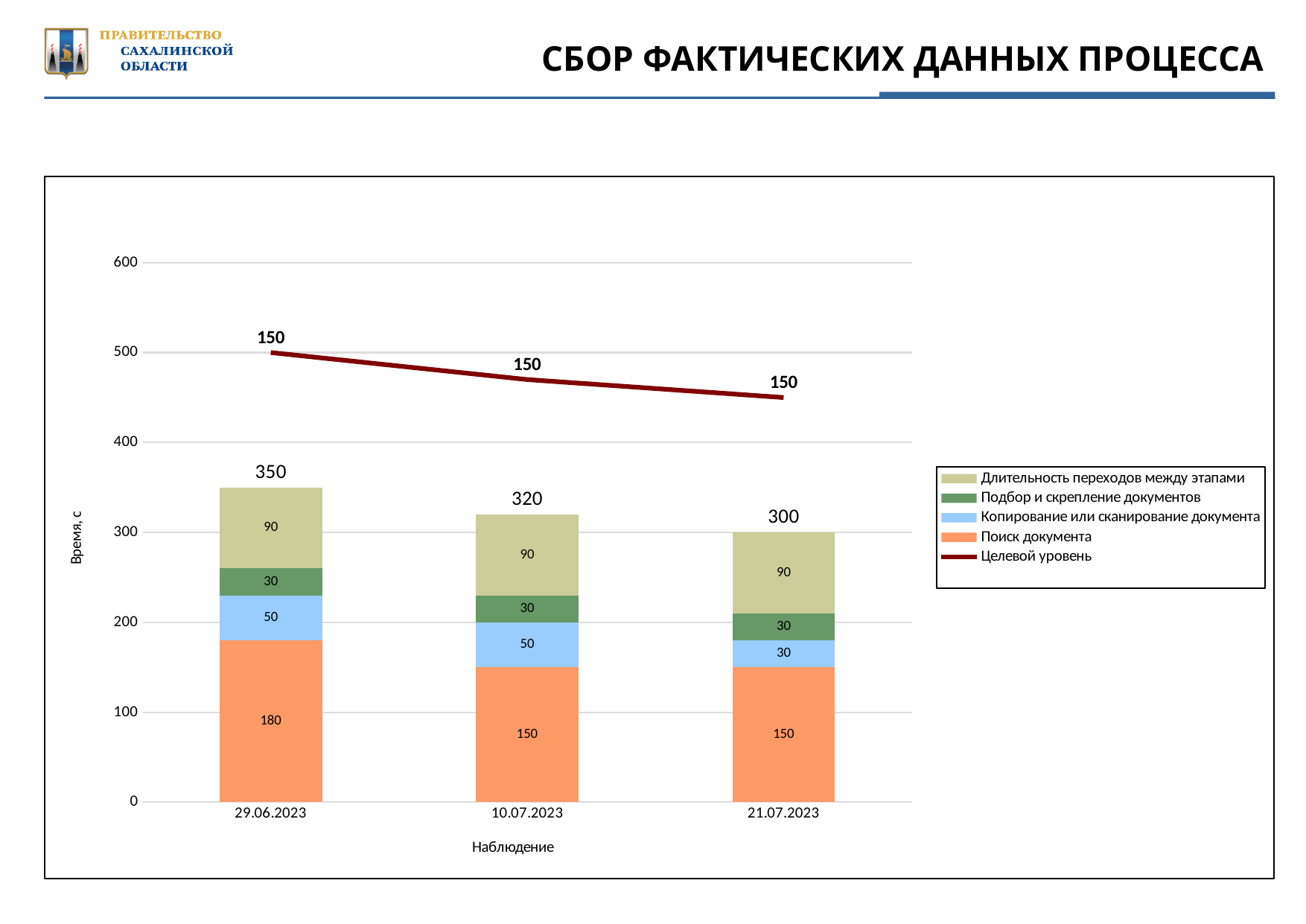
How many series does the legend list? 5 How many observation dates are shown on the x axis? 3 What is the value for Копирование или сканирование документа on 21.07.2023? 30 What is the total of the stacked bar for 10.07.2023? 320 What is the value for Поиск документа on 29.06.2023? 180 Do the stacked bar totals rise or fall from 29.06.2023 to 21.07.2023? fall Which observation date has the lowest stacked bar total? 21.07.2023 What is the difference between the stacked bar totals for 29.06.2023 and 21.07.2023? 50 Which is larger: the value for Поиск документа on 29.06.2023 or on 10.07.2023? 29.06.2023 What kind of chart is shown on the slide? combination bar and line chart What is the value of Целевой уровень on 10.07.2023? 150 Which observation date has the highest stacked bar total? 29.06.2023